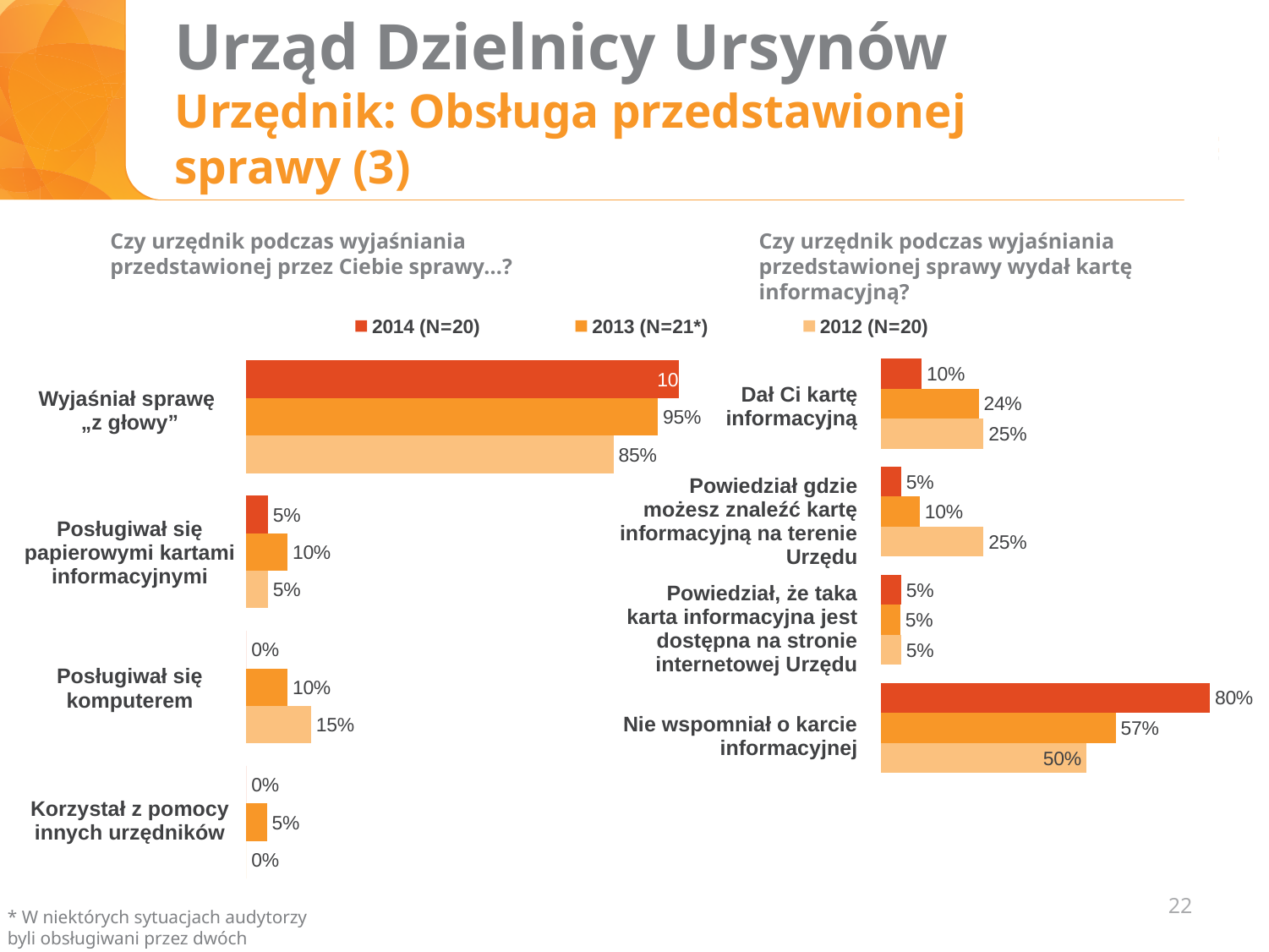
On the right chart, which category has the highest 2012 (N=20) value? Nie wspomniał o karcie informacyjnej On the right chart, which is larger for "Powiedział gdzie możesz znaleźć kartę informacyjną na terenie Urzędu": the 2012 (N=20) value or the 2014 (N=20) value? 2012 (N=20) On the right chart, what is the 2013 (N=21*) value for "Dał Ci kartę informacyjną"? 24% On the left chart, what is the 2013 (N=21*) value for "Posługiwał się komputerem"? 10% On the left chart, which category has the highest 2013 (N=21*) value? Wyjaśniał sprawę „z głowy” On the right chart, what is the difference between the 2014 (N=20) and 2012 (N=20) values for "Nie wspomniał o karcie informacyjnej"? 30% How many series does the legend list? 3 On the left chart, what is the 2012 (N=20) value for "Wyjaśniał sprawę „z głowy”"? 85% On the right chart, what is the 2014 (N=20) value for "Nie wspomniał o karcie informacyjnej"? 80% How many categories does the left chart show? 4 What type of chart is the right chart? Bar chart On the left chart, what is the difference between the 2012 (N=20) and 2013 (N=21*) values for "Posługiwał się komputerem"? 5%